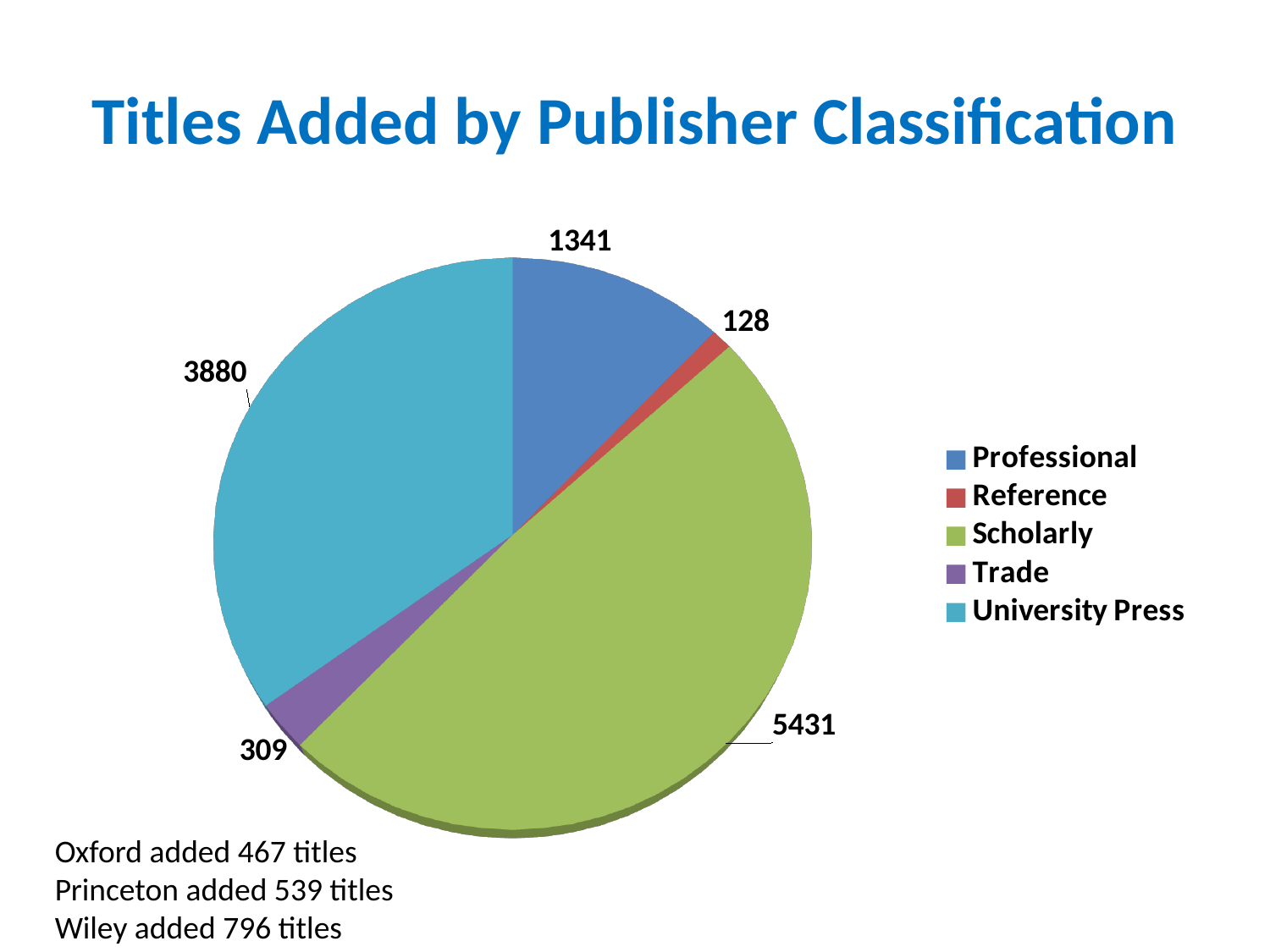
Which publisher classification has the smallest slice of the pie? Reference How many titles were added in the Reference classification? 128 How many titles were added in the University Press classification? 3880 How many titles were added in the Trade classification? 309 Which publisher classification has the largest slice of the pie? Scholarly How many titles were added in the Professional classification? 1341 How many publisher classifications does the legend list? 5 How many titles were added in the Scholarly classification? 5431 What type of chart is shown on the slide? Pie chart What is the title of the chart? Titles Added by Publisher Classification What is the difference between the Scholarly and University Press values? 1551 Which is larger, the Professional value or the Trade value? Professional